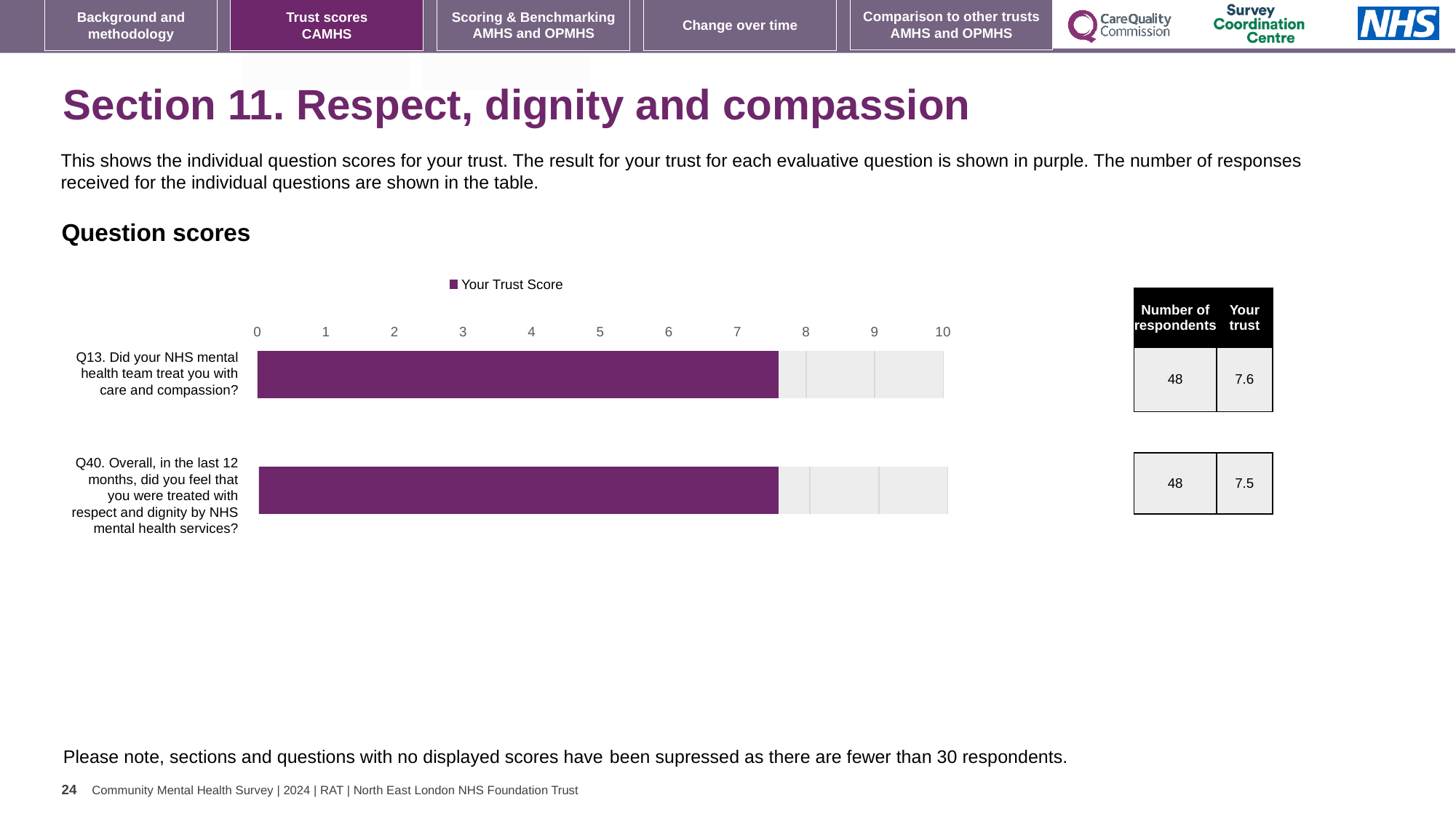
How many series does the legend of the Question scores chart list? 1 What is the name of the series shown in the chart legend? Your Trust Score How many questions are plotted in the Question scores chart? 2 What is the difference between the Your Trust Score for Q13 and for Q40? 0.1 How many respondents answered Q40 according to the table? 48 What is the Your Trust Score for Q13 (Did your NHS mental health team treat you with care and compassion?)? 7.6 Is the Your Trust Score for Q13 greater or less than 7? greater What is the Your Trust Score for Q40 (Overall, in the last 12 months, did you feel that you were treated with respect and dignity by NHS mental health services?)? 7.5 How many respondents answered Q13 according to the table? 48 Is the Your Trust Score for Q40 greater or less than 8? less What kind of chart is used to show the question scores? Bar chart Which question has the higher Your Trust Score, Q13 or Q40? Q13